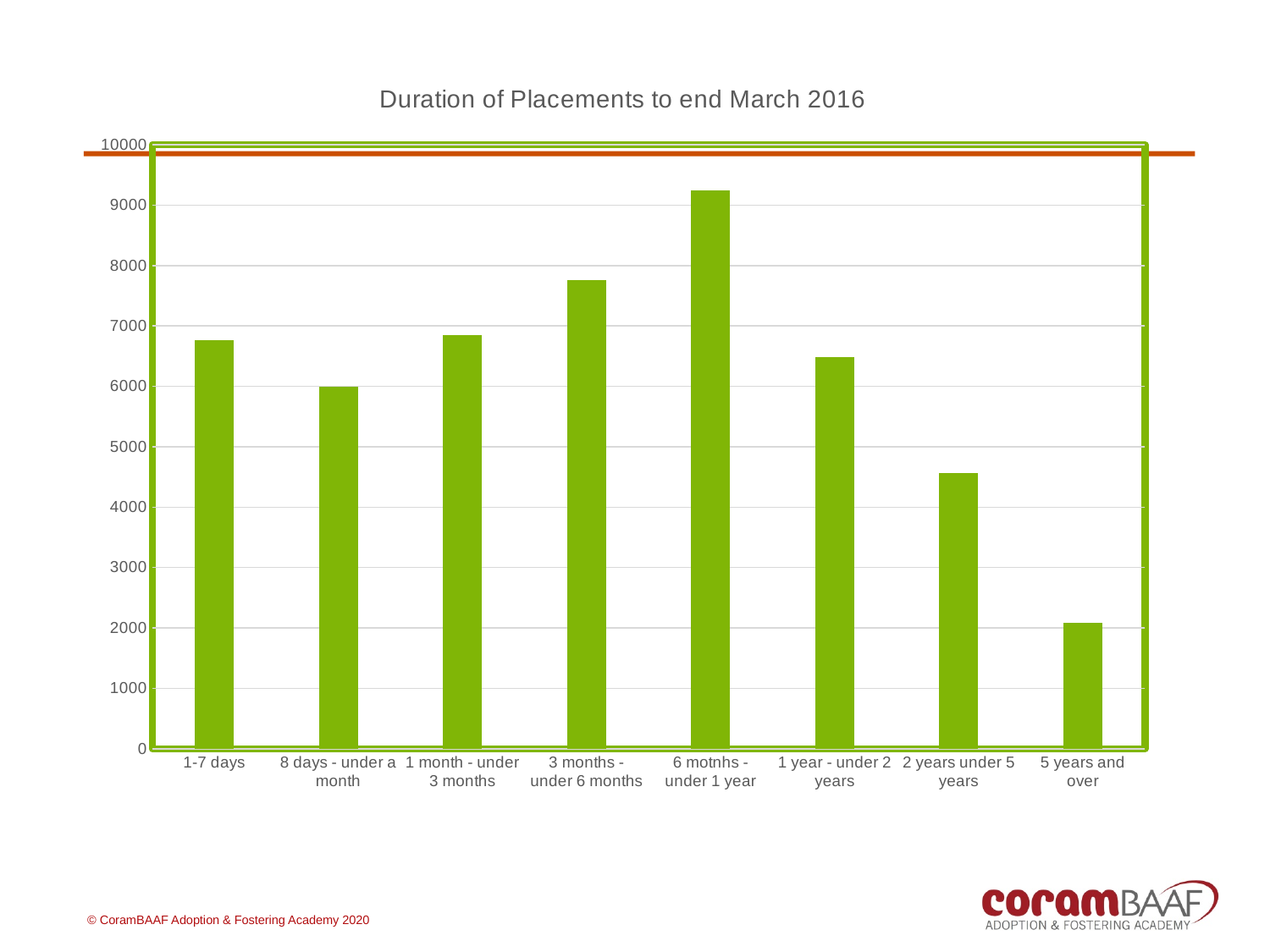
Which duration category has the highest value? 6 motnhs - under 1 year Is the value for 2 years under 5 years greater or less than 5000? less Do the values rise or fall from 6 motnhs - under 1 year to 5 years and over? fall Is the value for 5 years and over greater or less than 3000? less Which is larger, the value for 3 months - under 6 months or the value for 1 year - under 2 years? 3 months - under 6 months Is the value for 6 motnhs - under 1 year greater or less than 9000? greater How many duration categories are shown on the x axis? 8 What is the title of the chart? Duration of Placements to end March 2016 Which duration category has the lowest value? 5 years and over Which is larger, the value for 1-7 days or the value for 8 days - under a month? 1-7 days What type of chart is shown on the slide? bar chart